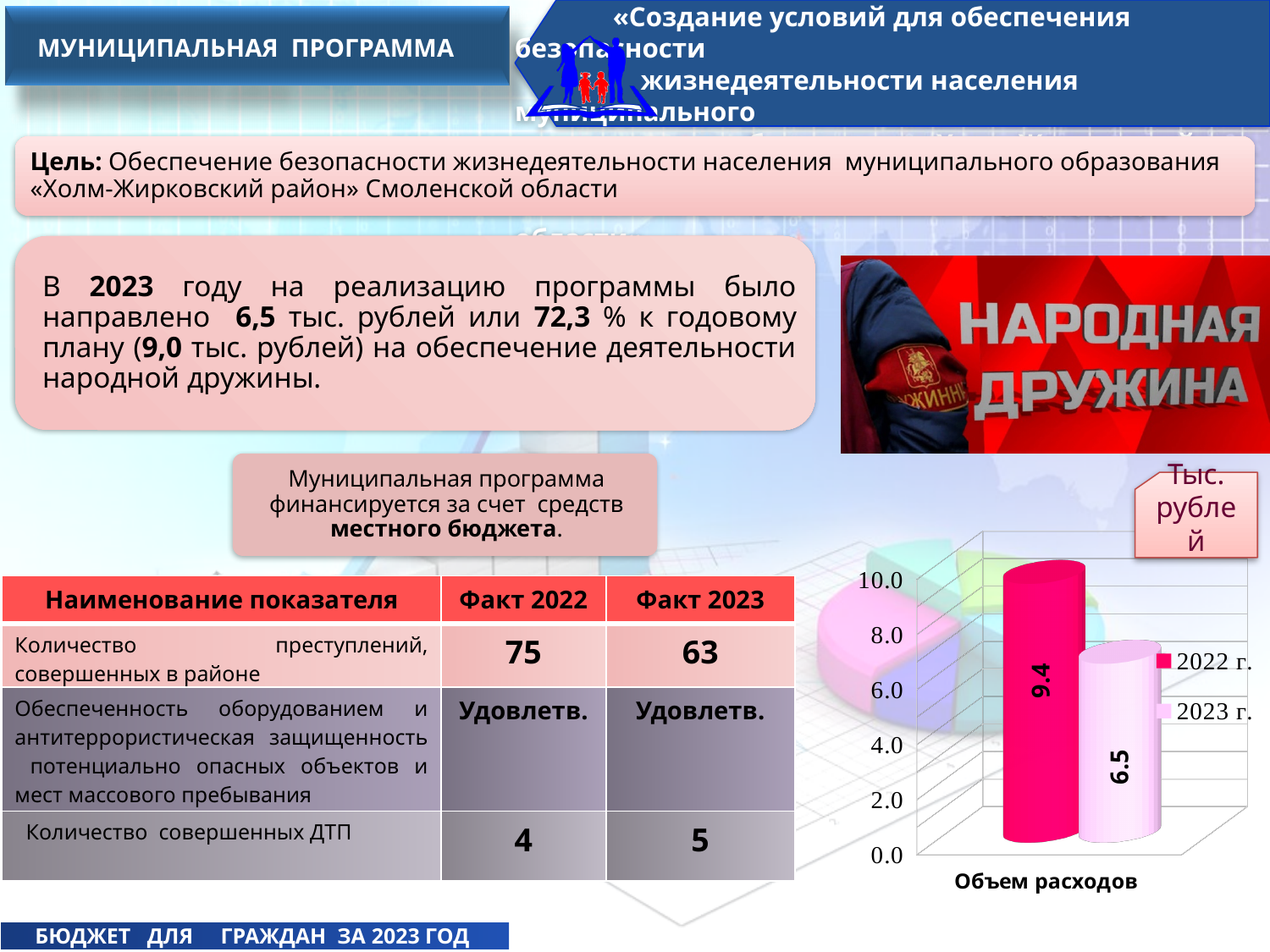
What is the value for 2022 г. in the chart? 9.4 Is the value for 2023 г. greater or less than 8.0? less How many series does the chart legend list? 2 How many categories are shown on the x axis of the chart? 1 Which series has the lowest value in the chart? 2023 г. Which series has the higher value in the chart, 2022 г. or 2023 г.? 2022 г. What is the value for 2023 г. in the chart? 6.5 What kind of chart is shown on the slide? bar chart What is the category label shown under the bars in the chart? Объем расходов Is the value for 2022 г. greater or less than 8.0? greater What is the difference between the 2022 г. and 2023 г. values in the chart? 2.9 What unit is indicated for the chart values? Тыс. рублей